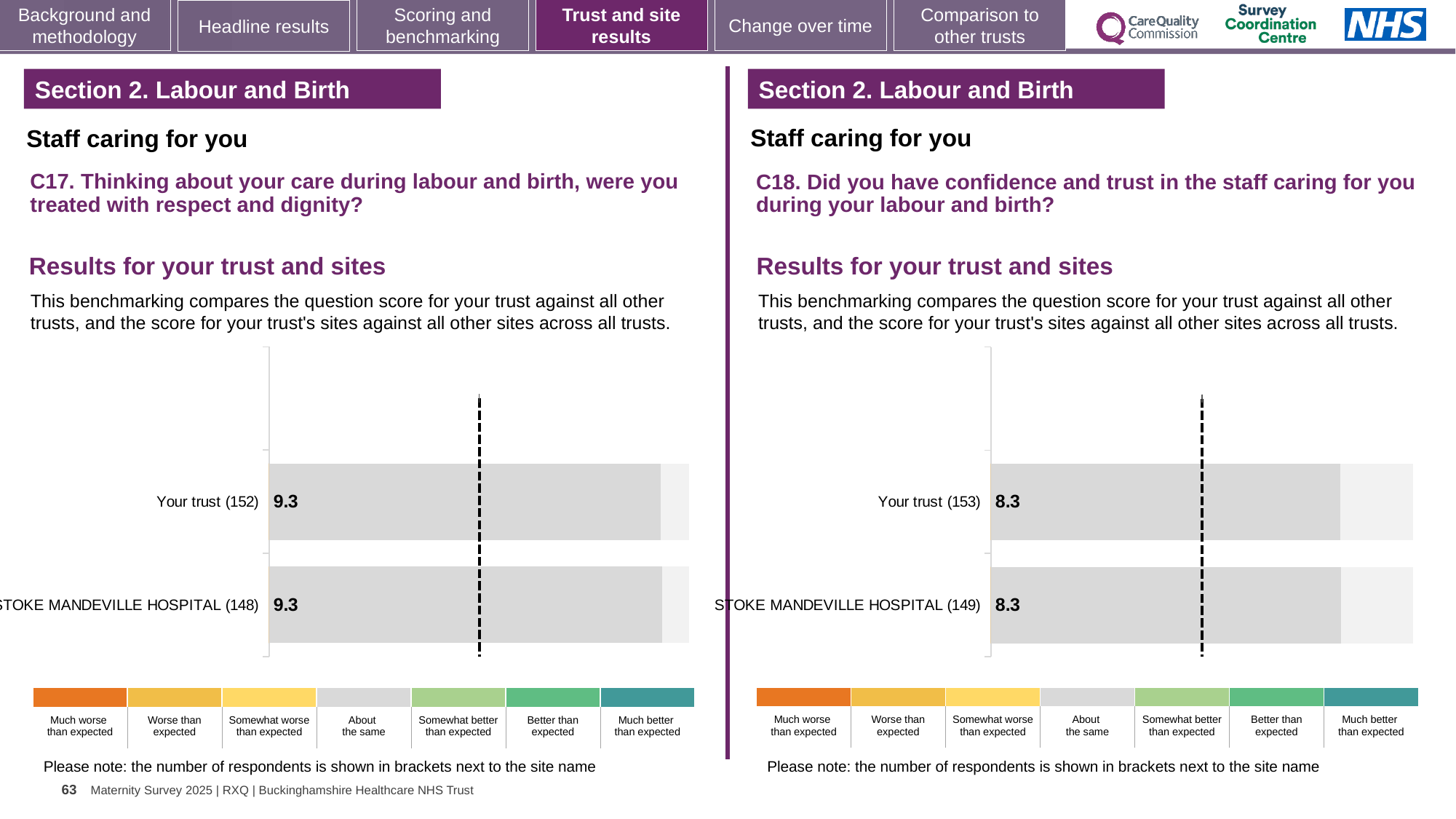
In the C17 chart on the left, what is the score for Your trust? 9.3 How many bars are plotted in the C18 chart on the right? 2 In the C18 chart on the right, what is the score for Your trust? 8.3 Is the Your trust score in the C17 chart on the left larger or smaller than the Your trust score in the C18 chart on the right? Larger In the C18 chart on the right, how many respondents are shown in brackets for Stoke Mandeville Hospital? 149 Which survey question does the chart on the right relate to? C18. Did you have confidence and trust in the staff caring for you during your labour and birth? In the C17 chart on the left, how many respondents are shown in brackets for Your trust? 152 What is the difference between the Your trust score in the C17 chart on the left and the Your trust score in the C18 chart on the right? 1.0 In the C17 chart on the left, what is the score for Stoke Mandeville Hospital? 9.3 What kind of chart is the C17 chart on the left? Bar chart How many benchmark categories does the colour key below the C17 chart on the left list? 7 In the C18 chart on the right, what is the score for Stoke Mandeville Hospital? 8.3